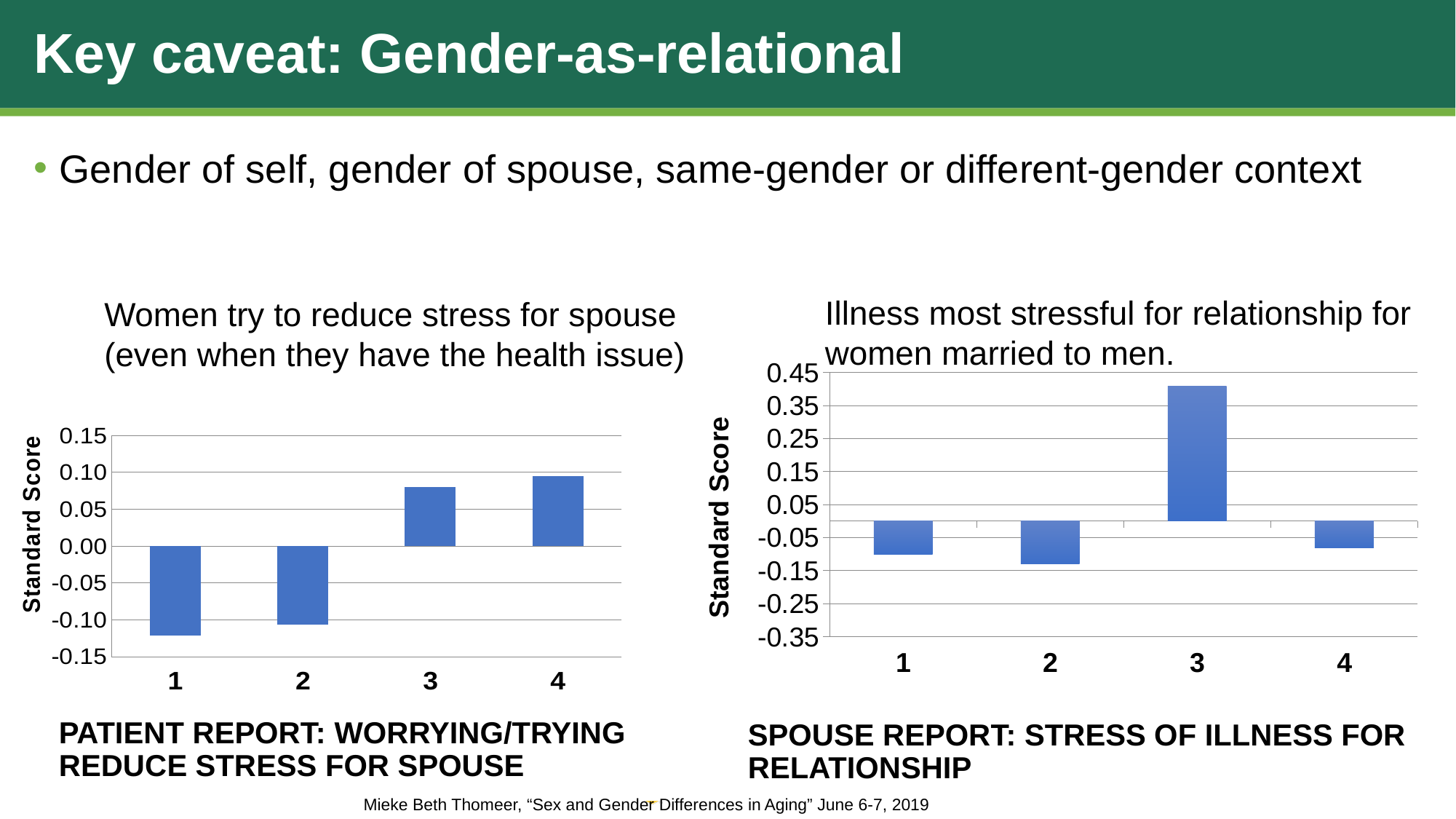
On the left chart, 'PATIENT REPORT', is the value for category 1 greater or less than -0.10? less What kind of chart is the left chart, 'PATIENT REPORT: WORRYING/TRYING REDUCE STRESS FOR SPOUSE'? Bar chart On the left chart, 'PATIENT REPORT', which category has the lowest value? 1 On the right chart, 'SPOUSE REPORT', which category has the lowest value? 2 On the right chart, 'SPOUSE REPORT', is the value for category 2 greater or less than -0.05? less On the right chart, 'SPOUSE REPORT', which category has the highest value? 3 On the right chart, 'SPOUSE REPORT', which has the higher value, category 1 or category 4? 4 How many categories are plotted on the right chart, 'SPOUSE REPORT: STRESS OF ILLNESS FOR RELATIONSHIP'? 4 On the left chart, 'PATIENT REPORT', which category has the highest value? 4 What is the y-axis label on the left chart, 'PATIENT REPORT'? Standard Score On the right chart, 'SPOUSE REPORT', is the value for category 3 greater or less than 0.35? greater